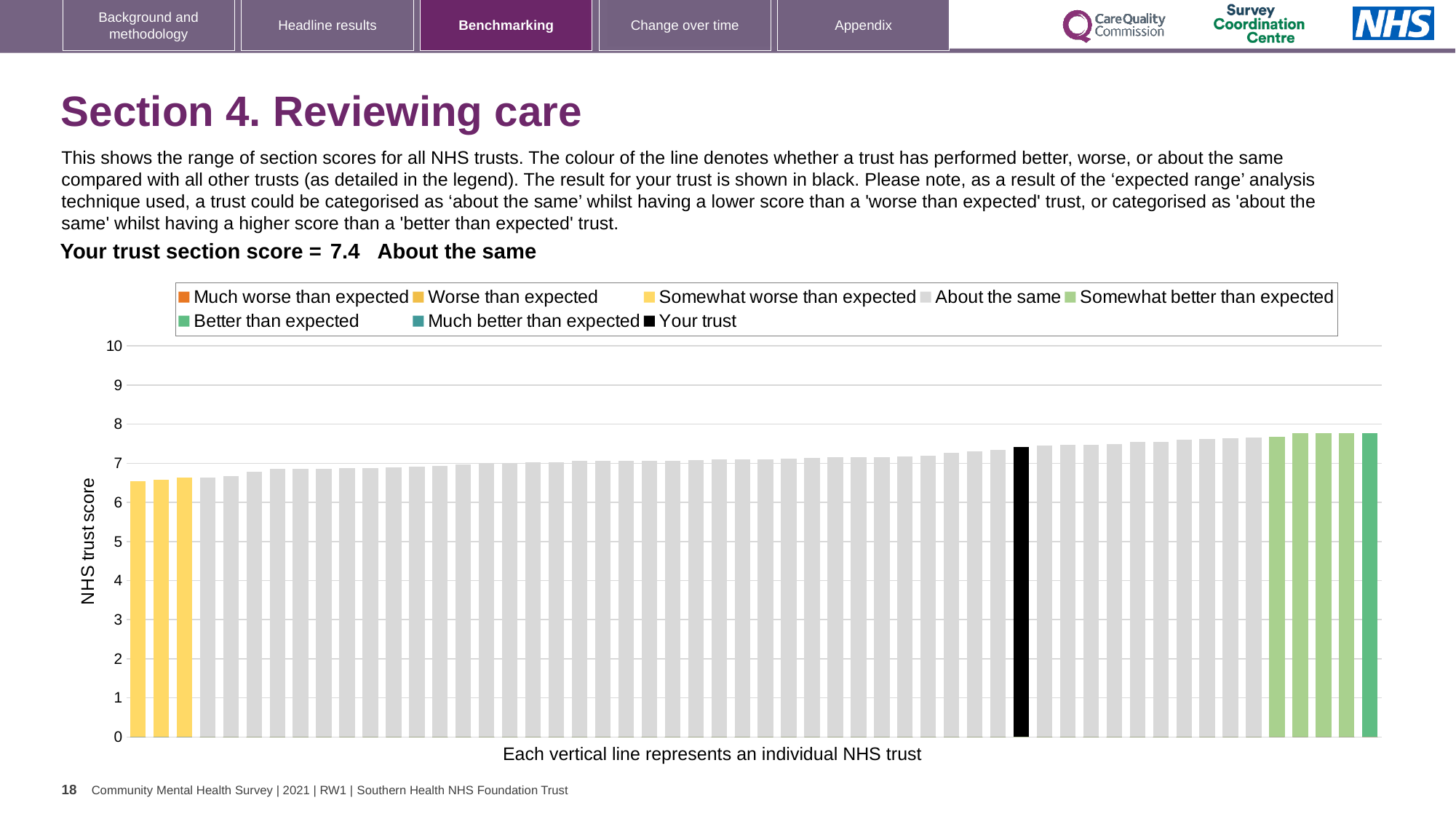
What is the section score for your trust? 7.4 Is the value for the leftmost bar greater or less than 6? greater Do the bar values rise or fall from left to right along the x axis? rise What is the label on the y axis? NHS trust score Which is larger, the rightmost bar or the black 'Your trust' bar? the rightmost bar What kind of chart is shown on the slide? bar chart Which category is your trust placed in for this section? About the same Is the value for the black 'Your trust' bar greater or less than 7? greater Is the value for the leftmost bar greater or less than 7? less How many entries does the chart legend list? 8 How many bars are coloured yellow? 3